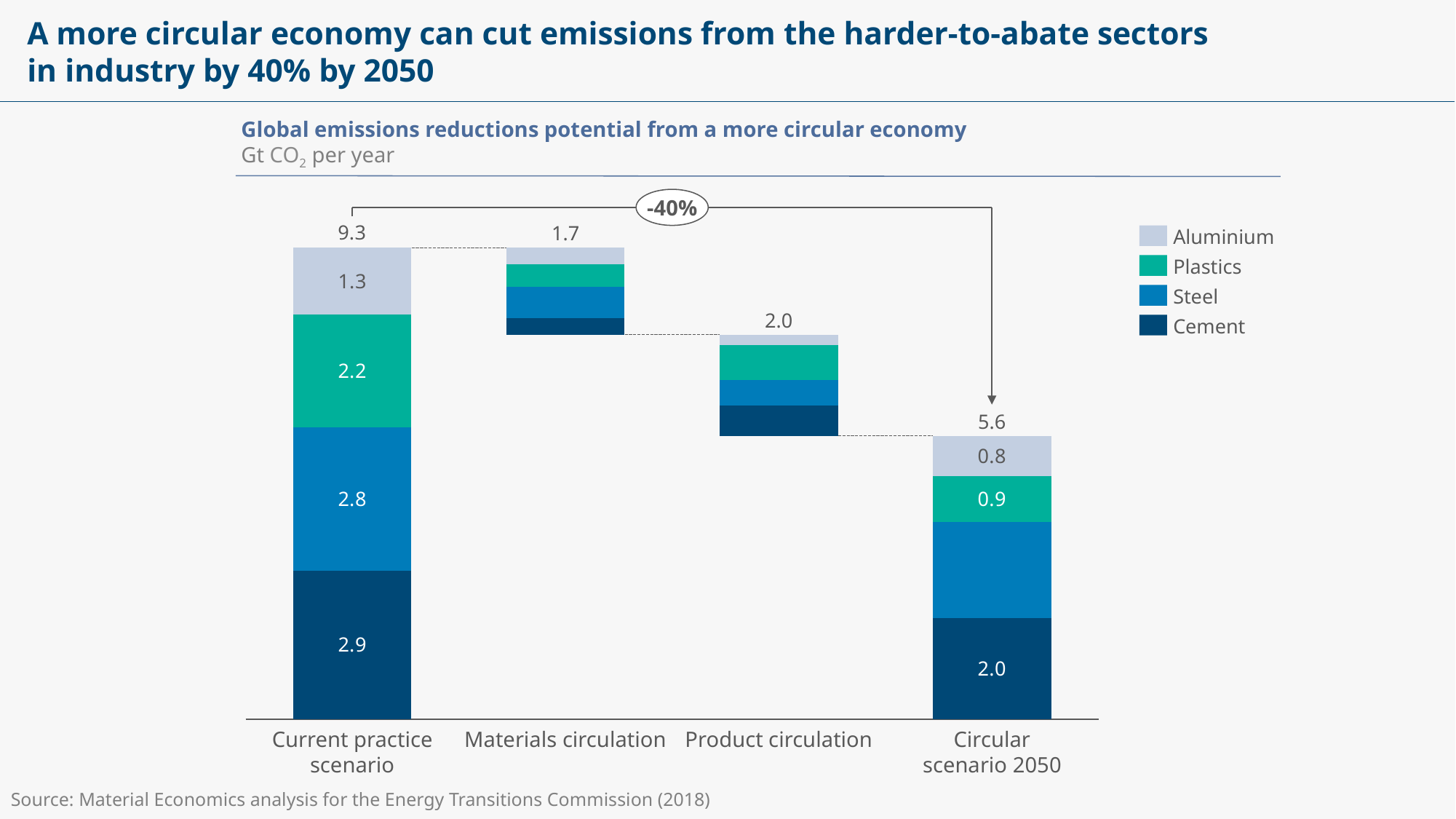
What percentage reduction is shown between the Current practice scenario and the Circular scenario 2050? -40% Which is larger: the Steel value or the Plastics value in the Current practice scenario bar? Steel What is the difference between the Current practice scenario total and the Circular scenario 2050 total? 3.7 Which bar has the lowest total value? Materials circulation What is the total value for the Current practice scenario bar? 9.3 What is the value shown for Product circulation? 2.0 Which bar has the highest total value? Current practice scenario How many bars are shown on the x axis? 4 What is the Plastics value in the Circular scenario 2050 bar? 0.9 What is the Cement value in the Current practice scenario bar? 2.9 How many series does the legend list? 4 What is the value shown for Materials circulation? 1.7